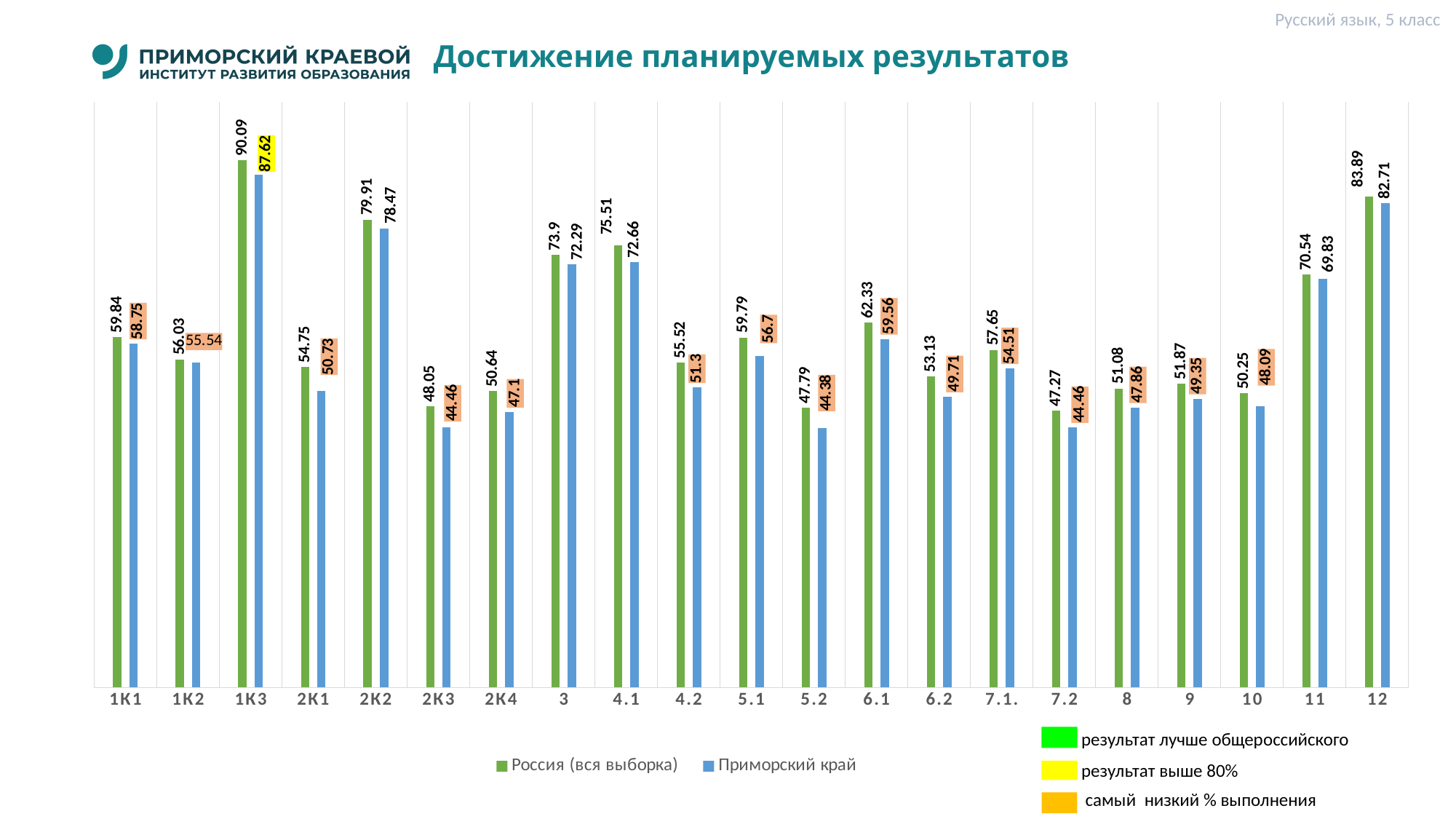
What is the difference between the Россия (вся выборка) and Приморский край values in category 12? 1.18 How many categories are shown on the x axis? 21 Which series is shown in blue? Приморский край What is the value for Россия (вся выборка) in category 2К2? 79.91 What is the title of the chart on the slide? Достижение планируемых результатов Which category has the highest value for Россия (вся выборка)? 1К3 Which is larger in category 6.1: the value for Россия (вся выборка) or for Приморский край? Россия (вся выборка) What is the value for Приморский край in category 1К3? 87.62 Which category has the lowest value for Приморский край? 5.2 How many series does the legend list? 2 What is the value for Приморский край in category 5.2? 44.38 What kind of chart is shown on the slide? bar chart